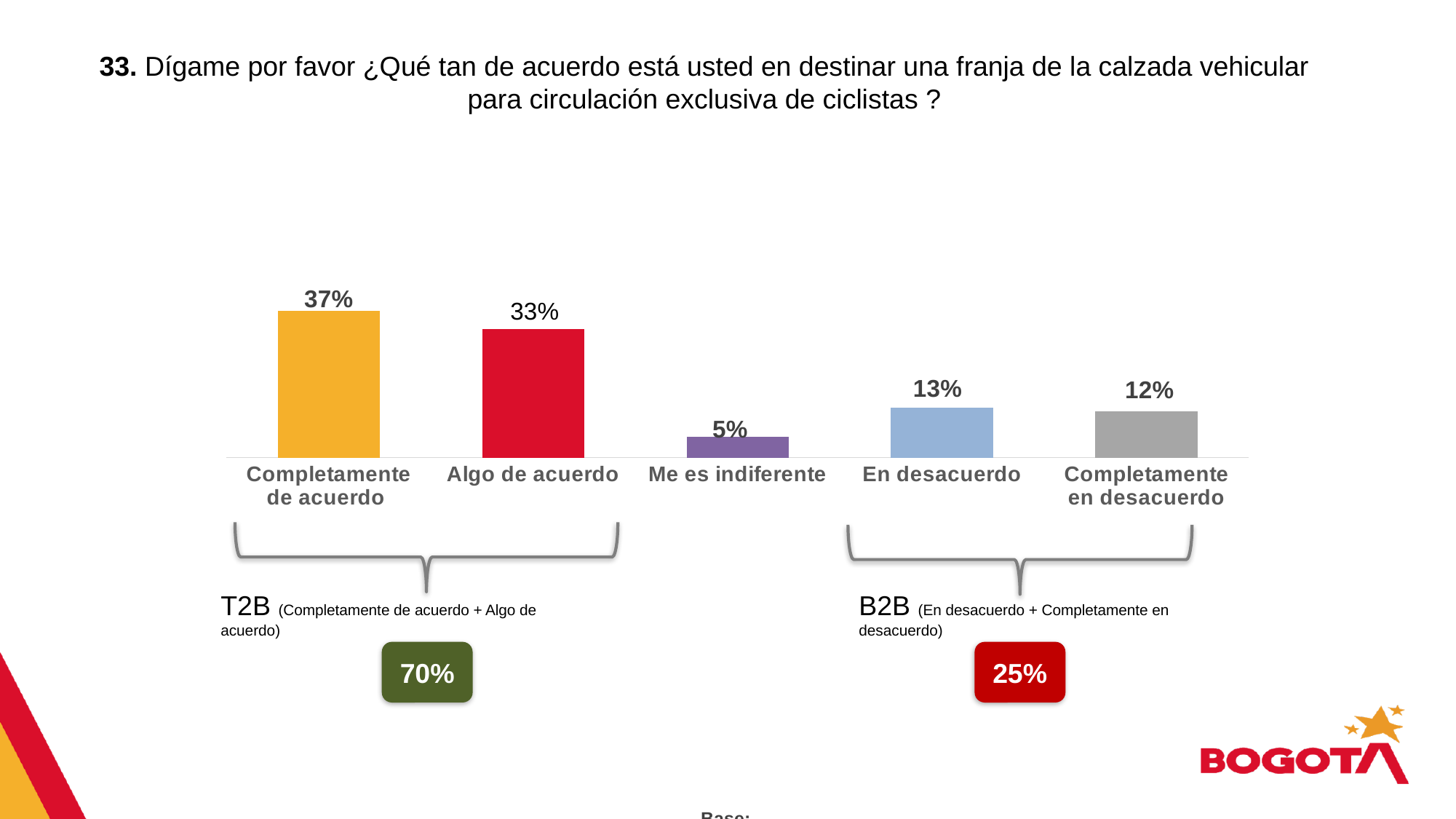
Which category has the highest value? Completamente de acuerdo What type of chart is shown on the slide? Bar chart What T2B value (Completamente de acuerdo + Algo de acuerdo) is shown on the slide? 70% Which is larger, "En desacuerdo" or "Me es indiferente"? En desacuerdo What is the difference between "Completamente de acuerdo" and "Algo de acuerdo"? 4% Which category has the lowest value? Me es indiferente What percentage is shown for "Me es indiferente"? 5% What is the value for "Completamente en desacuerdo"? 12% What is the value shown for "Algo de acuerdo"? 33% What percentage of respondents answered "Completamente de acuerdo"? 37% What is the value for "En desacuerdo"? 13% How many categories are shown in the chart? 5